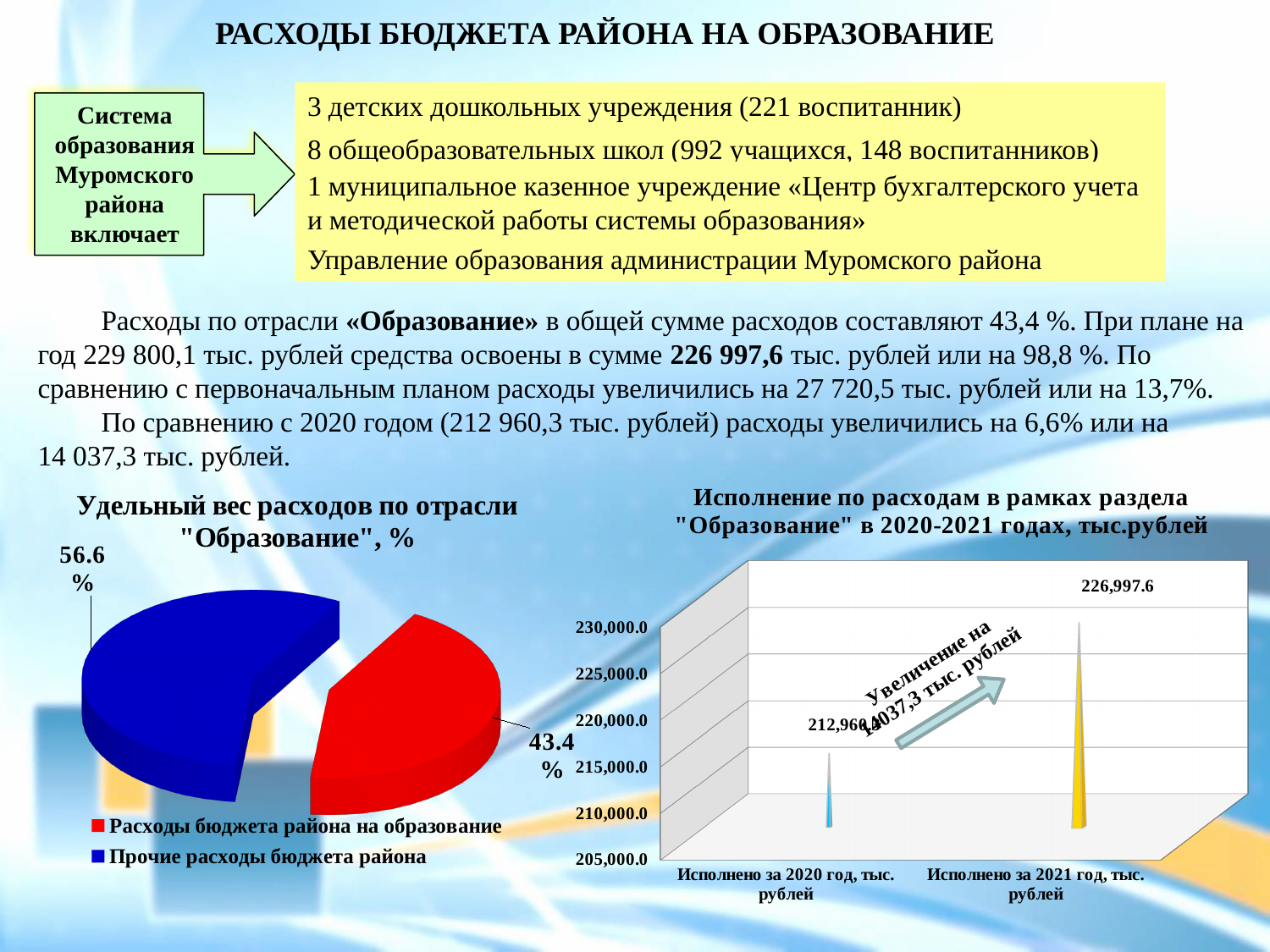
In the pie chart "Удельный вес расходов по отрасли "Образование", %", what share is shown for "Прочие расходы бюджета района"? 56.6% In the pie chart on the left, what is the difference between the two slices' shares? 13.2% What type of chart is the chart on the right titled "Исполнение по расходам в рамках раздела "Образование" в 2020-2021 годах, тыс.рублей"? Bar chart In the pie chart on the left, what colour is the slice for "Расходы бюджета района на образование"? Red In the pie chart on the left, which slice is larger: "Расходы бюджета района на образование" or "Прочие расходы бюджета района"? Прочие расходы бюджета района In the chart on the right, which category has the lowest value? Исполнено за 2020 год, тыс. рублей How many slices does the pie chart on the left have? 2 In the pie chart "Удельный вес расходов по отрасли "Образование", %", what share is shown for "Расходы бюджета района на образование"? 43.4% In the chart on the right, is the value for "Исполнено за 2020 год, тыс. рублей" greater or less than 215,000.0? less In the chart on the right, what is the value for "Исполнено за 2021 год, тыс. рублей"? 226,997.6 In the chart on the right, which category has the highest value? Исполнено за 2021 год, тыс. рублей In the chart on the right, do the values rise or fall from 2020 to 2021? Rise